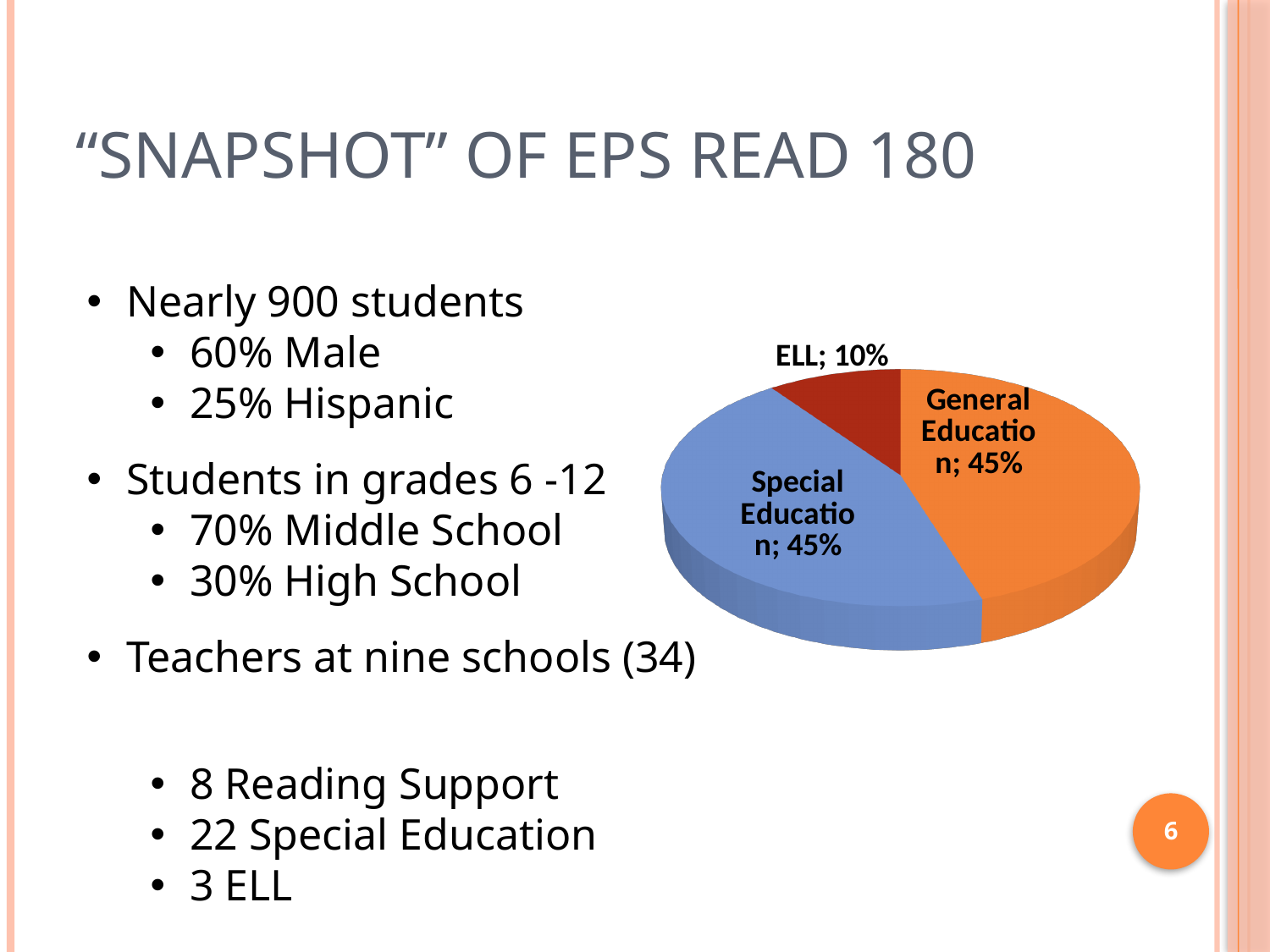
What colour is the Special Education slice of the pie chart? blue What share of the pie does General Education represent? 45% What is the difference in percentage points between the General Education slice and the ELL slice? 35 Which slice of the pie chart is the smallest? ELL What kind of chart is shown on the slide? pie chart What share of the pie does ELL represent? 10% How many slices does the pie chart have? 3 What is the combined share of the General Education and Special Education slices? 90% What share of the pie does Special Education represent? 45% Which is larger, the Special Education slice or the ELL slice? Special Education What colour is the ELL slice of the pie chart? dark red